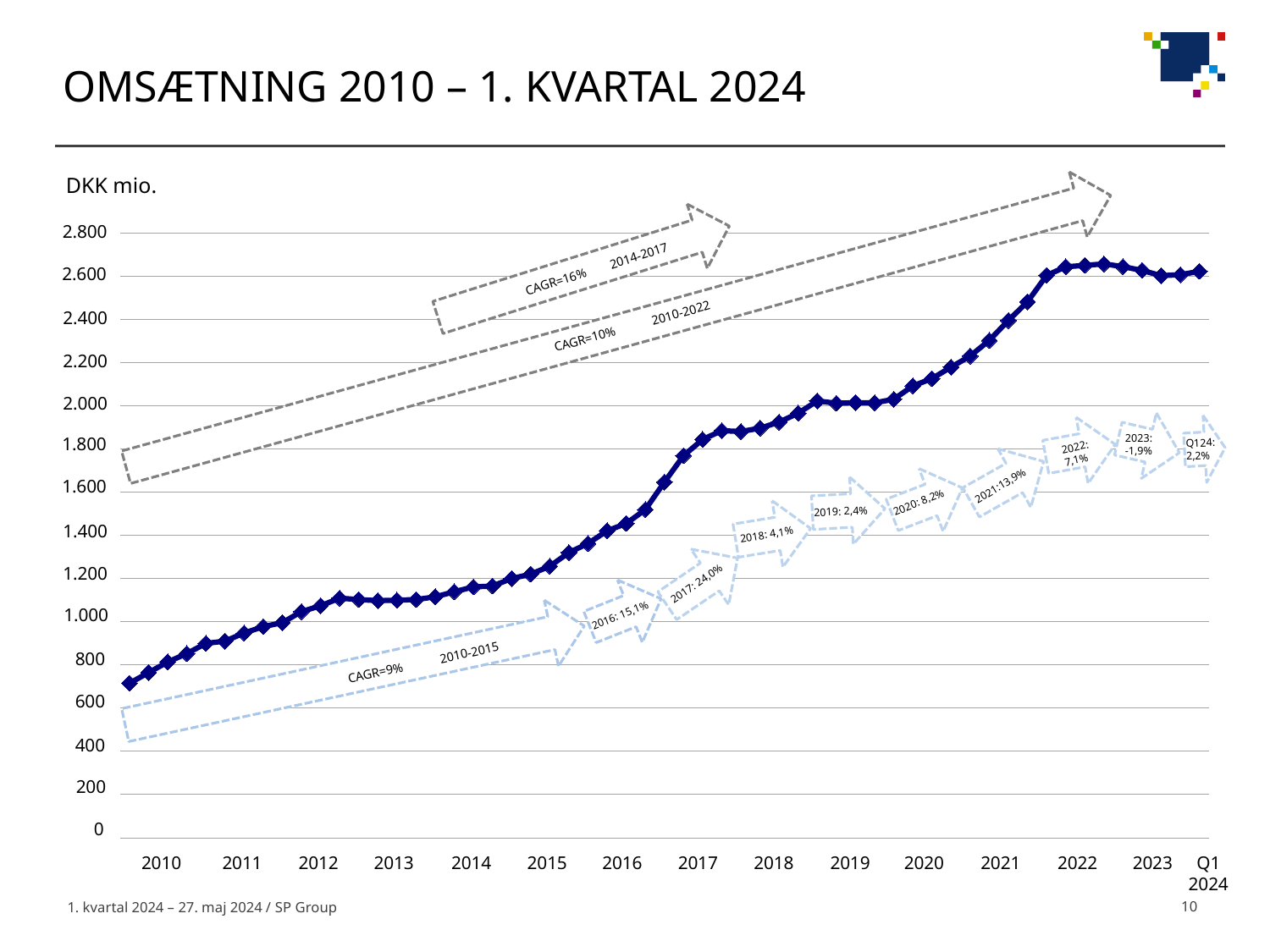
What kind of chart is shown on the slide? line chart What CAGR is shown for the period 2010-2015? CAGR=9% What growth rate is annotated for 2017? 24,0% What CAGR is shown for the period 2014-2017? CAGR=16% Does revenue generally rise or fall from 2010 to 2022? rise Is the revenue value in 2023 greater or less than 2.400? greater What is the title of the chart on the slide? OMSÆTNING 2010 – 1. KVARTAL 2024 What unit is shown above the y axis of the chart? DKK mio. What growth rate is annotated for 2023? -1,9% Which year on the x axis has the lowest revenue? 2010 Is the revenue value in 2021 greater or less than 2.000? greater Is the revenue value at the start of 2010 greater or less than 800? less